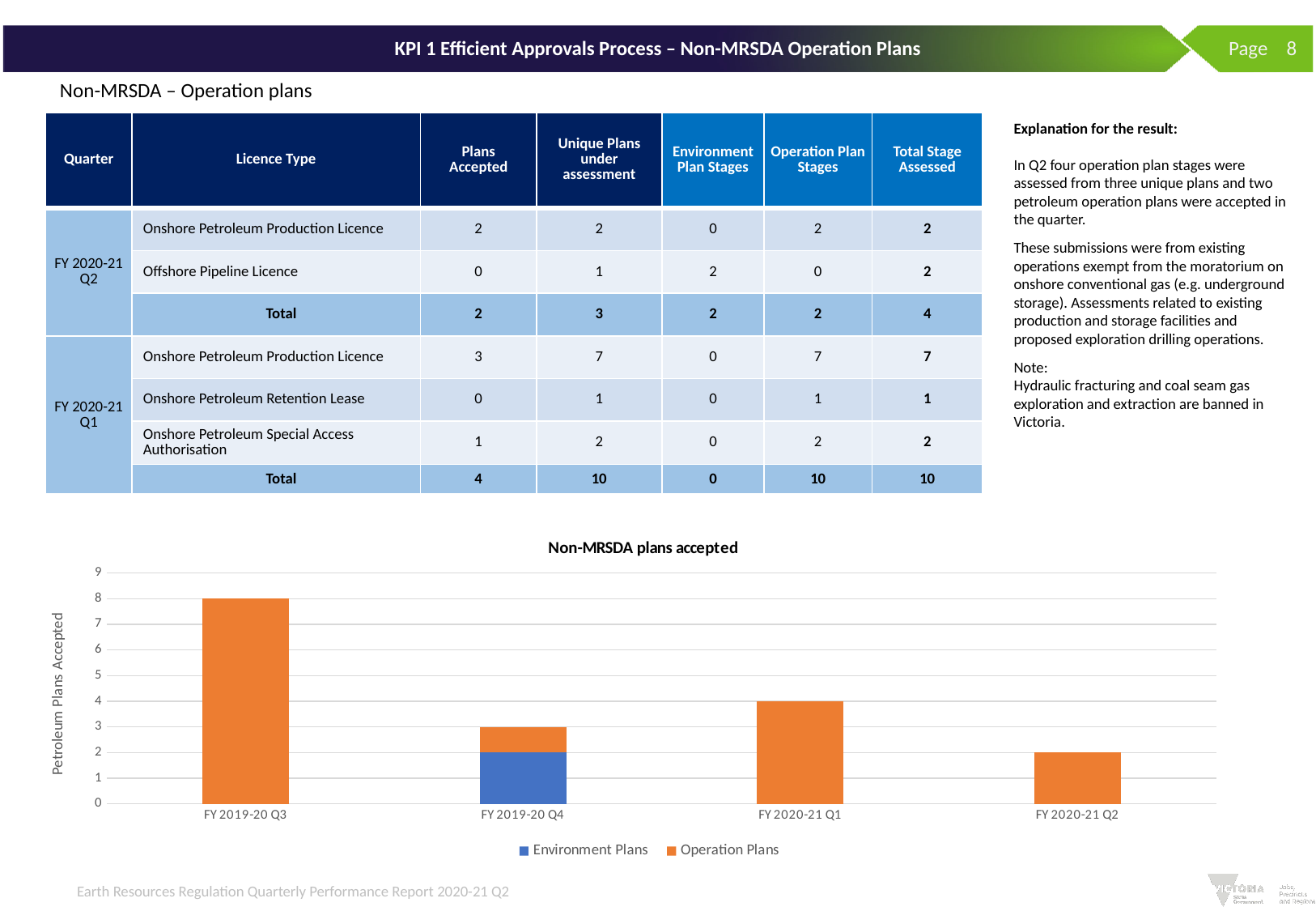
In the 'Non-MRSDA plans accepted' chart, which quarter has the tallest bar? FY 2019-20 Q3 In the 'Non-MRSDA plans accepted' chart, what is the value of Operation Plans for FY 2020-21 Q2? 2 In the 'Non-MRSDA plans accepted' chart, what is the total height of the stacked bar for FY 2019-20 Q4? 3 In the 'Non-MRSDA plans accepted' chart, what is the value of Operation Plans for FY 2020-21 Q1? 4 In the 'Non-MRSDA plans accepted' chart, is the bar for FY 2020-21 Q1 taller or shorter than the bar for FY 2020-21 Q2? Taller In the 'Non-MRSDA plans accepted' chart, which colour represents Environment Plans? Blue How many quarters are shown on the x axis of the 'Non-MRSDA plans accepted' chart? 4 In the 'Non-MRSDA plans accepted' chart, is the value for FY 2019-20 Q3 greater or less than 5? greater In the 'Non-MRSDA plans accepted' chart, what is the value of Environment Plans for FY 2019-20 Q4? 2 In the 'Non-MRSDA plans accepted' chart, what is the value of Operation Plans for FY 2019-20 Q3? 8 What kind of chart is the 'Non-MRSDA plans accepted' chart? Stacked bar chart How many series does the legend of the 'Non-MRSDA plans accepted' chart list? 2